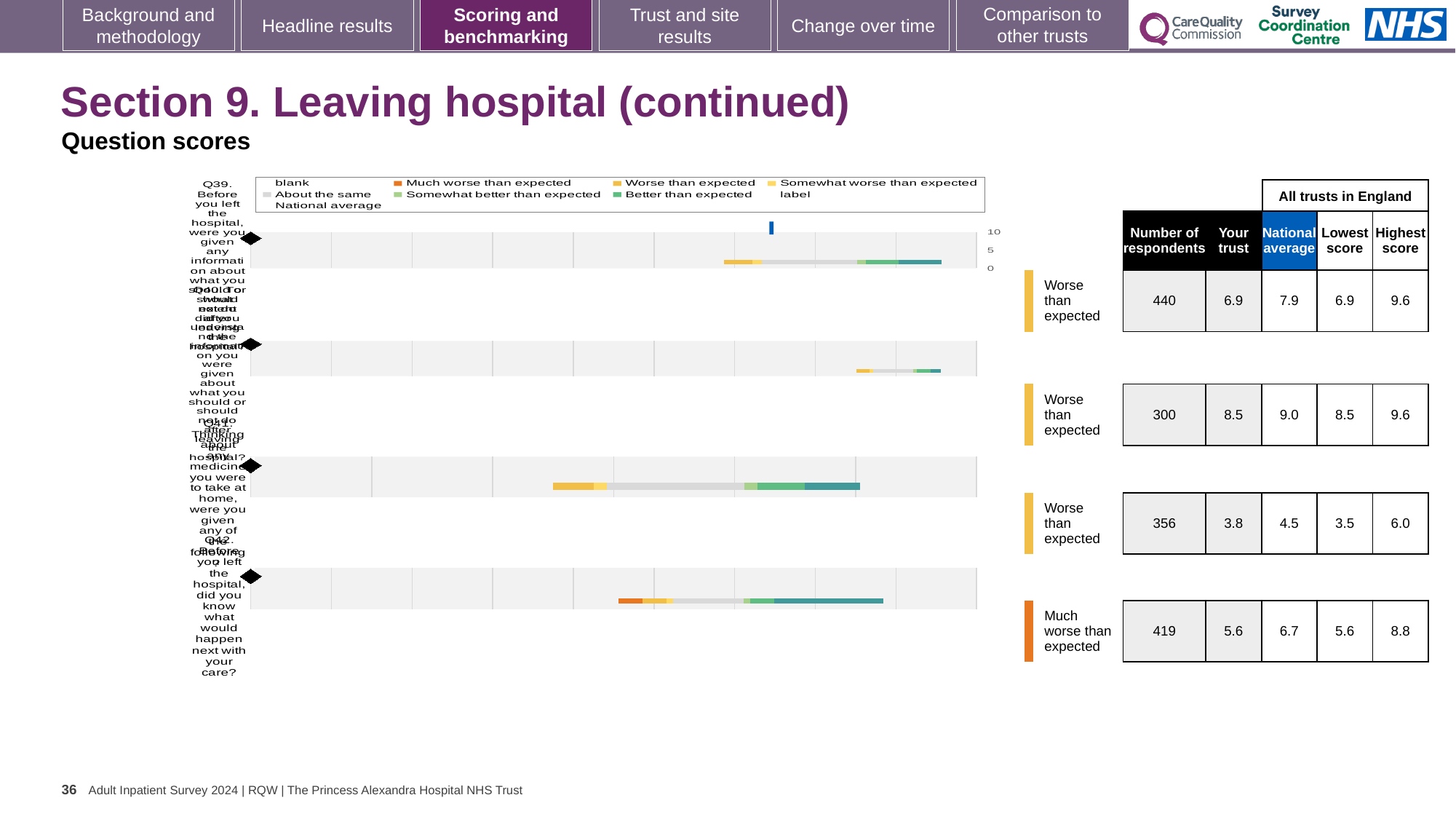
In the table beside the chart, what is the 'Your trust' score for Q41? 3.8 What kind of chart is shown on the slide? bar chart In the table beside the chart, what is the national average for Q40? 9.0 Which question has the highest 'Your trust' score in the table beside the chart? Q40 What colour does the legend use for 'Much worse than expected'? orange In the table beside the chart, what is the 'Your trust' score for Q39? 6.9 What is the difference between the national average and the 'Your trust' score for Q42? 1.1 How many questions (rows) are plotted in the chart? 4 Which question numbers are plotted in the chart? Q39, Q40, Q41, Q42 In the table beside the chart, how many respondents answered Q41? 356 In the table beside the chart, what is the highest score for Q42? 8.8 Which question has the lowest 'Your trust' score in the table beside the chart? Q41